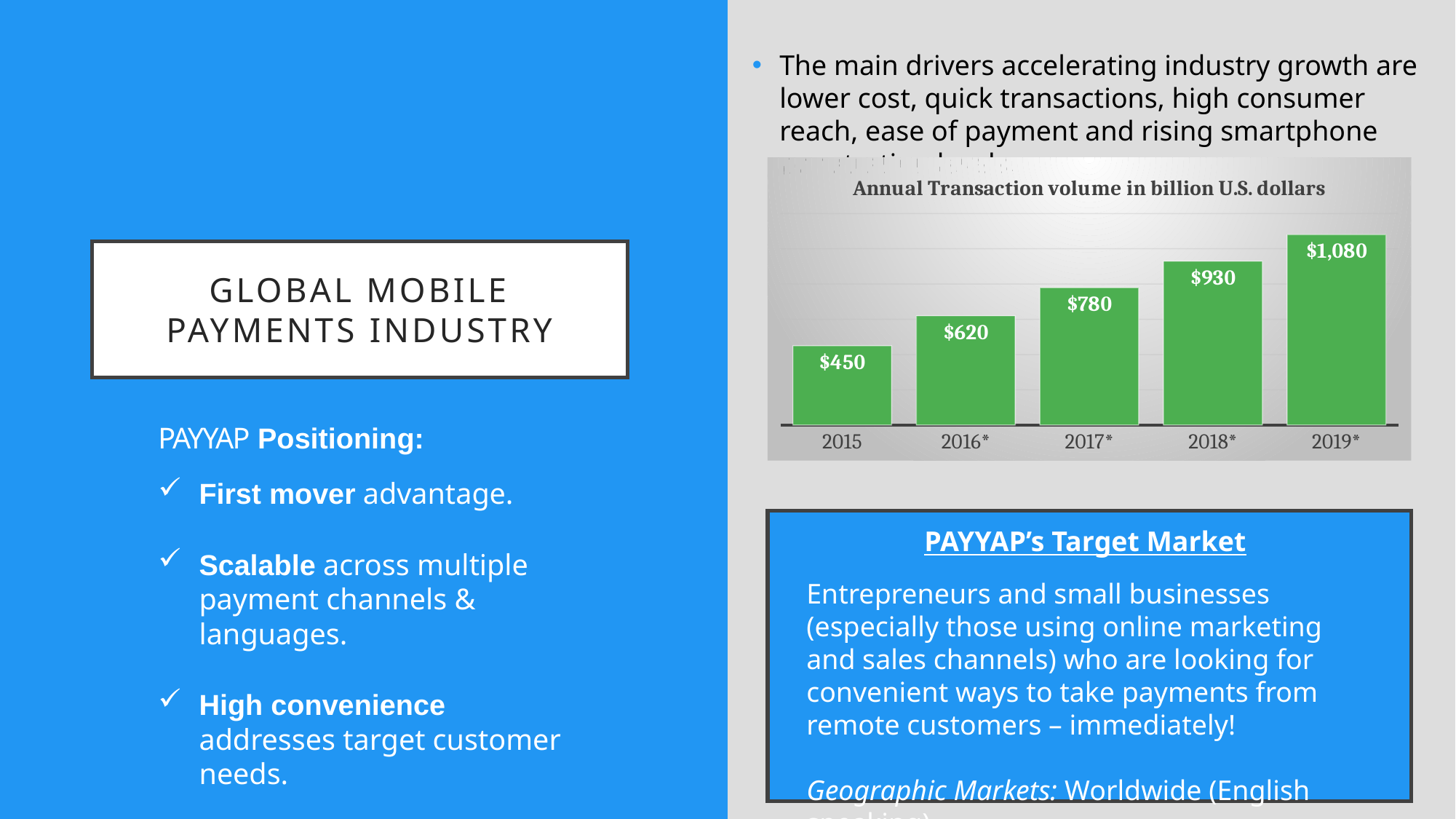
What is the title of the chart? Annual Transaction volume in billion U.S. dollars What is the difference between the transaction volume for 2019* and 2015? $630 Which year has the highest annual transaction volume? 2019* What is the annual transaction volume shown for 2015? $450 What is the annual transaction volume shown for 2019*? $1,080 What is the annual transaction volume shown for 2017*? $780 What kind of chart is used to show annual transaction volume? Bar chart Do the annual transaction volumes rise or fall from 2015 to 2019*? Rise How many years are shown on the chart? 5 Which year has the lowest annual transaction volume? 2015 Which is larger, the transaction volume for 2016* or for 2017*? 2017* What is the difference between the transaction volume for 2018* and 2016*? $310